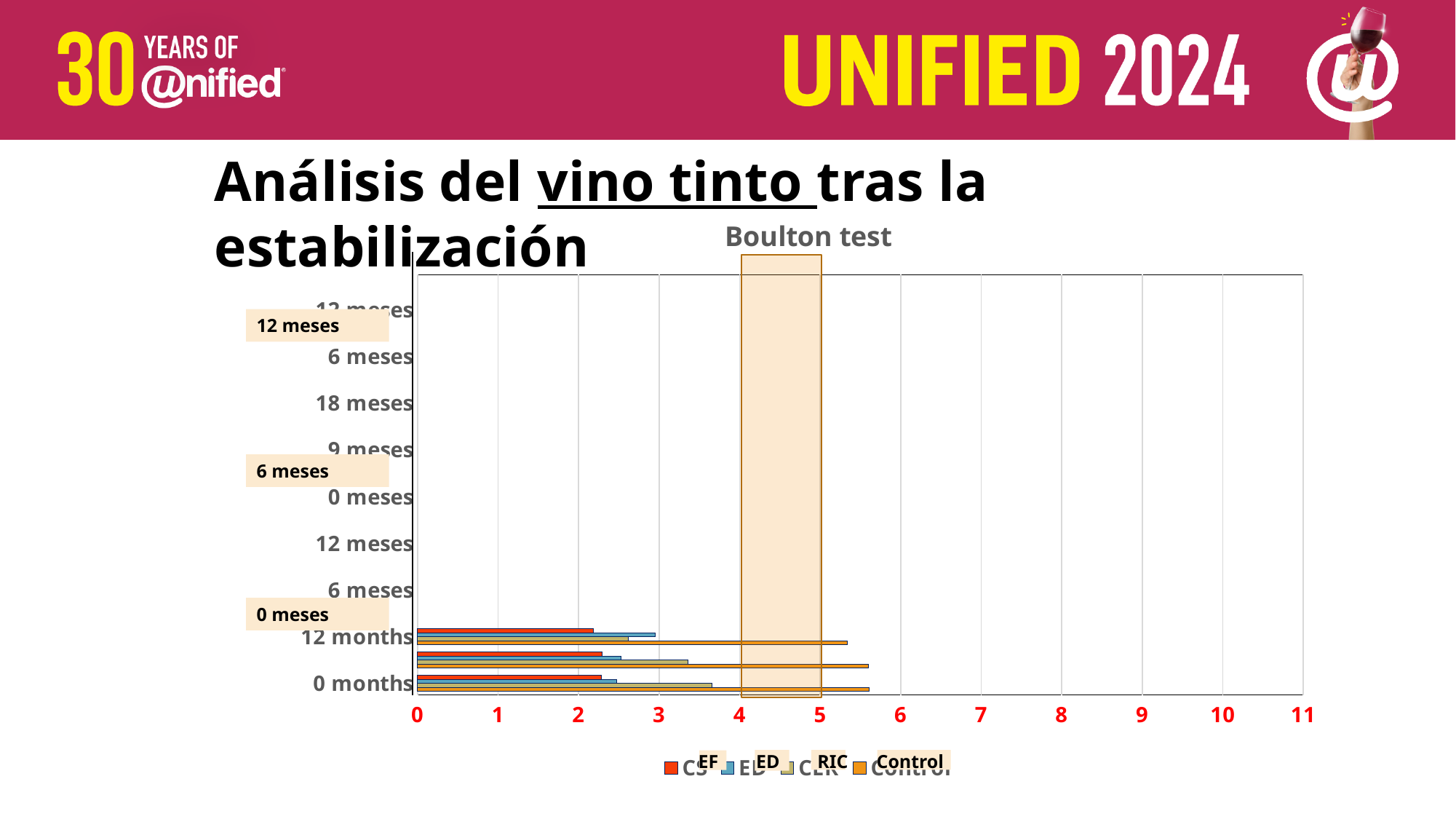
What is the highest value shown on the x axis? 11 Which series has the shortest bar for 12 months? CS Which series has the longest bar for 0 months? Control For 12 months, which is larger, the ED value or the CLR value? ED Is the CS value for 0 months greater or less than 3? less Is the Control value for 0 months greater or less than 5? greater How many series does the chart legend list? 4 What type of chart is shown on the slide? bar chart Is the Control value for 0 months greater or less than 6? less What is the title of the chart? Boulton test